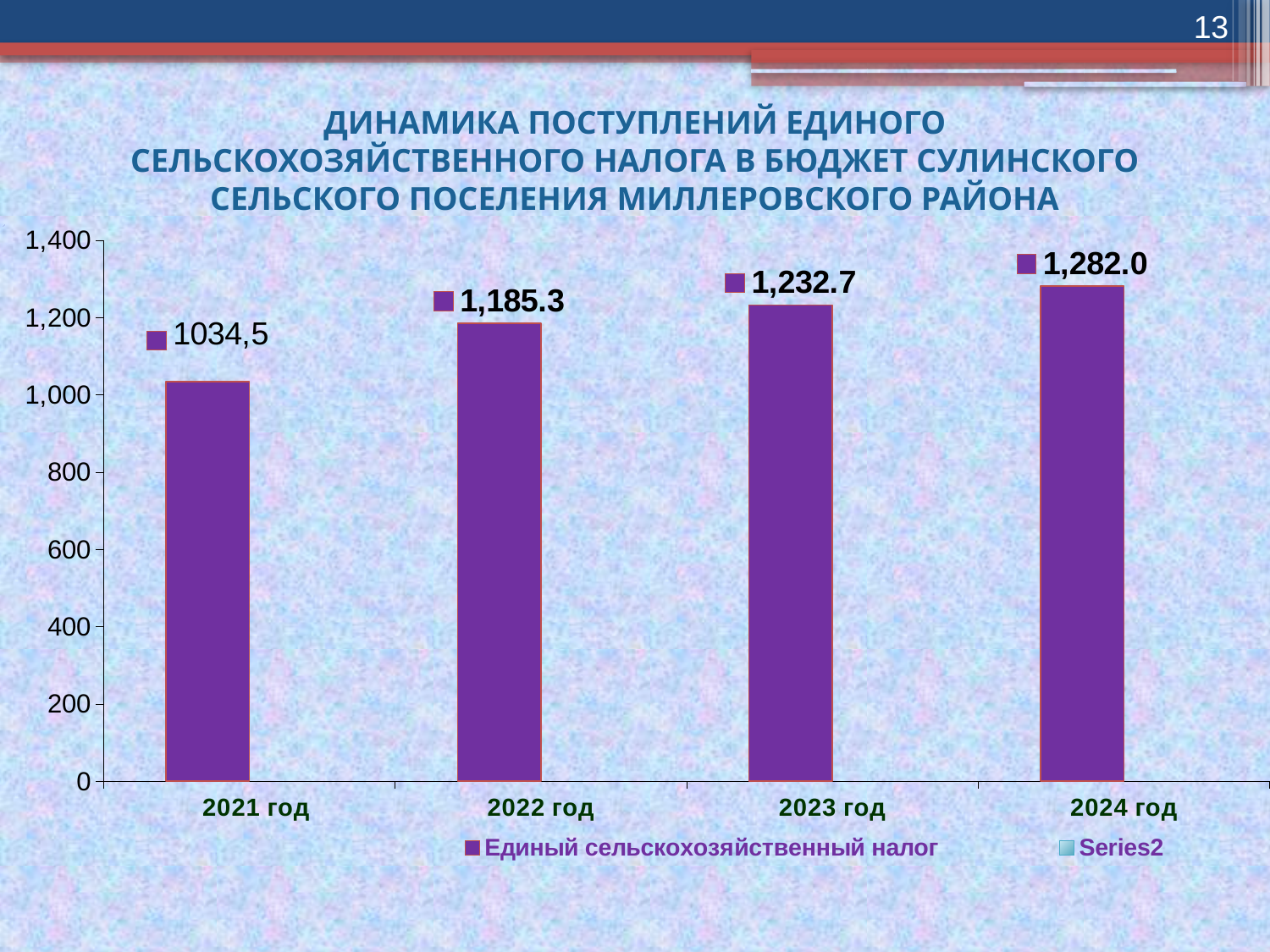
What is the value for 2024 год? 1,282.0 What is the value for 2022 год? 1,185.3 How many years are shown on the x axis? 4 What is the value for 2021 год? 1034,5 What is the difference between the values for 2023 год and 2022 год? 47.4 What is the value for 2023 год? 1,232.7 Which year has the lowest value? 2021 год What is the difference between the values for 2024 год and 2023 год? 49.3 What kind of chart is shown on the slide? bar chart Which year has the highest value? 2024 год Which is larger, the value for 2022 год or the value for 2024 год? 2024 год How many series does the legend list? 2